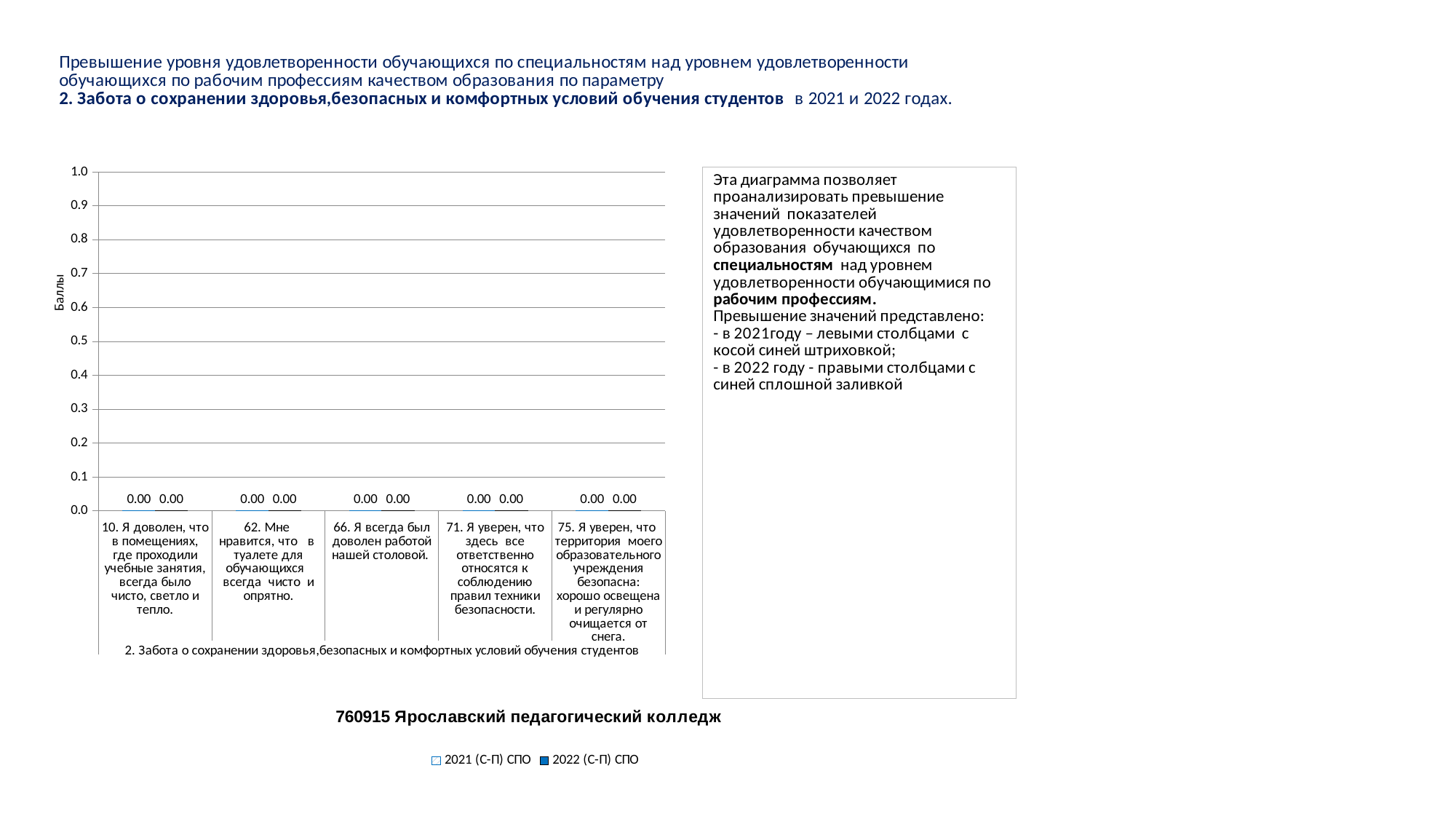
What are the two series names listed in the chart legend? 2021 (С-П) СПО and 2022 (С-П) СПО What is the difference between the 2021 (С-П) СПО and 2022 (С-П) СПО values for category 62 ("Мне нравится, что в туалете для обучающихся всегда чисто и опрятно")? 0.00 What is the highest value shown on the vertical axis of the chart? 1.0 What is the value for the 2021 (С-П) СПО series for category 10 ("Я доволен, что в помещениях, где проходили учебные занятия, всегда было чисто, светло и тепло")? 0.00 How many categories are shown on the x axis of the chart? 5 What kind of chart is shown on the slide? Bar chart What is the value for the 2022 (С-П) СПО series for category 66 ("Я всегда был доволен работой нашей столовой")? 0.00 What is the label of the vertical axis of the chart? Баллы How many series does the chart legend list? 2 Do the values for the 2022 (С-П) СПО series rise or fall across the categories on the x axis? Neither, they stay flat at 0.00 What is the value for the 2021 (С-П) СПО series for category 75 ("Я уверен, что территория моего образовательного учреждения безопасна")? 0.00 What is the value for the 2022 (С-П) СПО series for category 71 ("Я уверен, что здесь все ответственно относятся к соблюдению правил техники безопасности")? 0.00